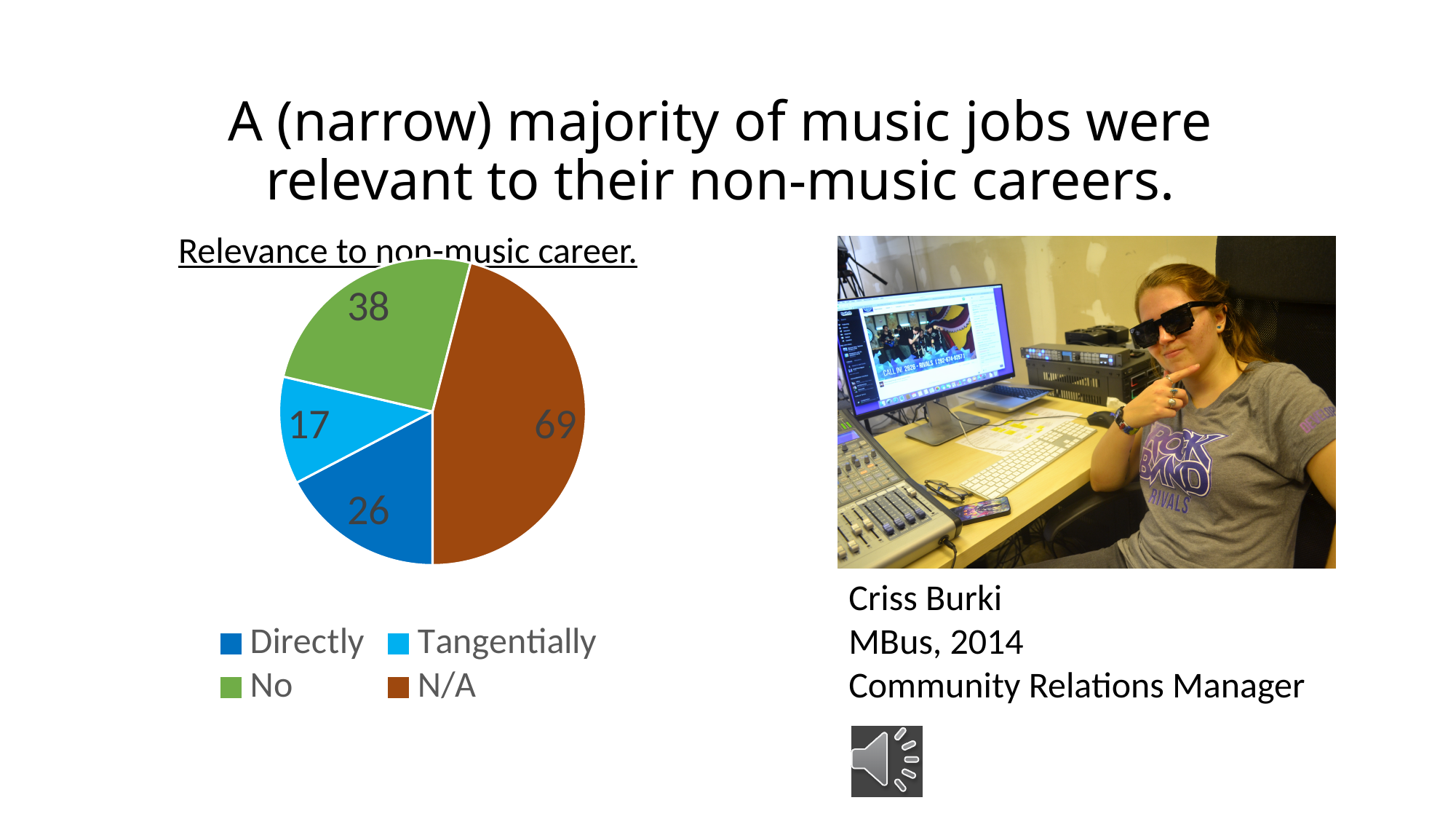
What is the value for the N/A slice of the pie chart? 69 How many categories does the pie chart legend list? 4 What type of chart is shown on the slide? pie chart What is the total of all the slice values in the pie chart? 150 What is the value for the Directly slice of the pie chart? 26 What is the value for the Tangentially slice of the pie chart? 17 What is the difference between the N/A value and the No value in the pie chart? 31 Which is larger in the pie chart, Directly or Tangentially? Directly What is the title of the pie chart? Relevance to non-music career. What is the value for the No slice of the pie chart? 38 Which category has the largest slice in the pie chart? N/A Which category has the smallest slice in the pie chart? Tangentially